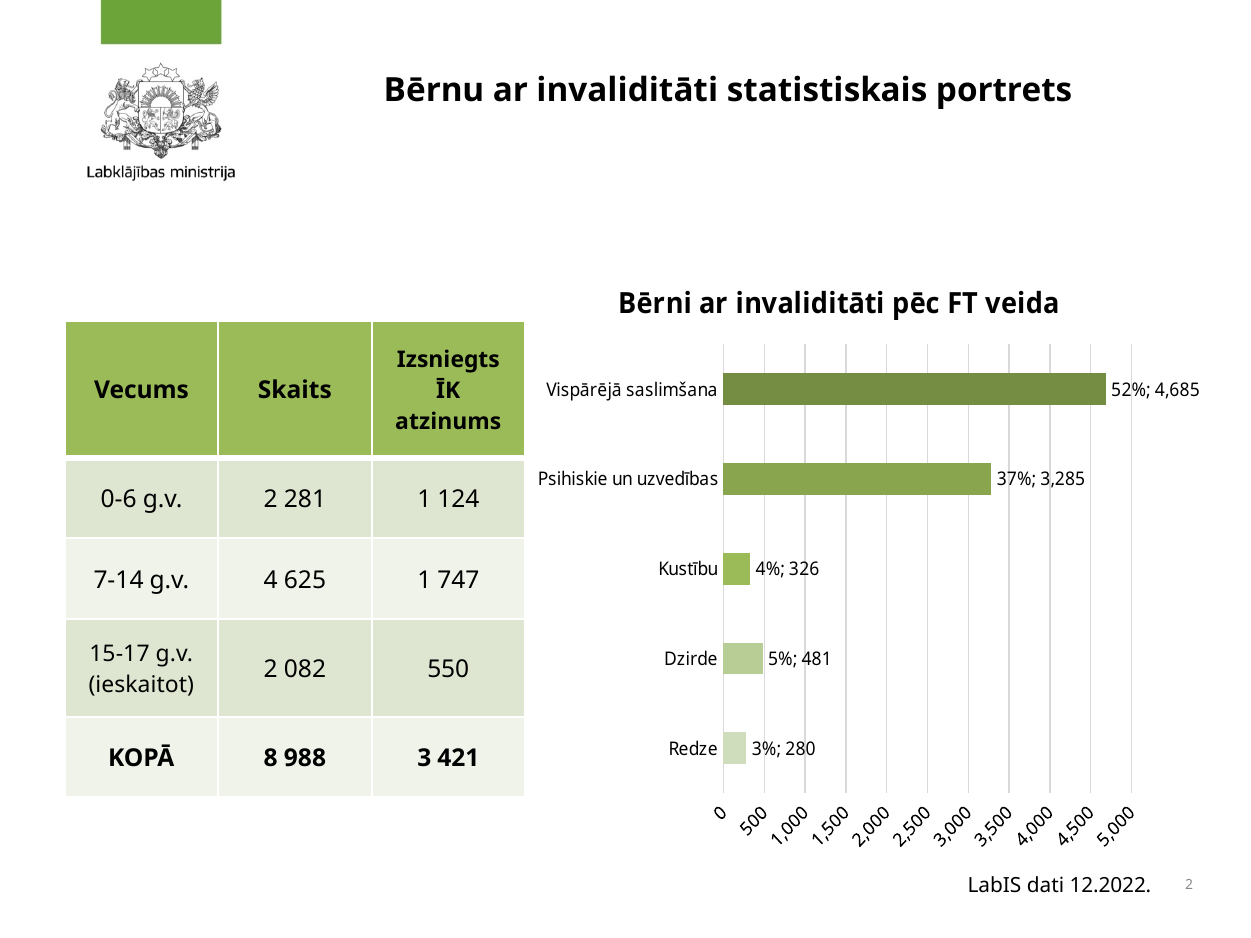
What kind of chart is shown on the slide? bar chart Which category has the lowest value in the chart? Redze What is the data label shown for Vispārējā saslimšana? 52%; 4,685 What is the difference in count between Vispārējā saslimšana and Psihiskie un uzvedības? 1,400 How many categories does the chart show? 5 What is the title of the chart on the slide? Bērni ar invaliditāti pēc FT veida Which has a larger value, Dzirde or Kustību? Dzirde What is the data label shown for Kustību? 4%; 326 Which category has the highest value in the chart? Vispārējā saslimšana What is the data label shown for Dzirde? 5%; 481 What is the data label shown for Redze? 3%; 280 What is the data label shown for Psihiskie un uzvedības? 37%; 3,285